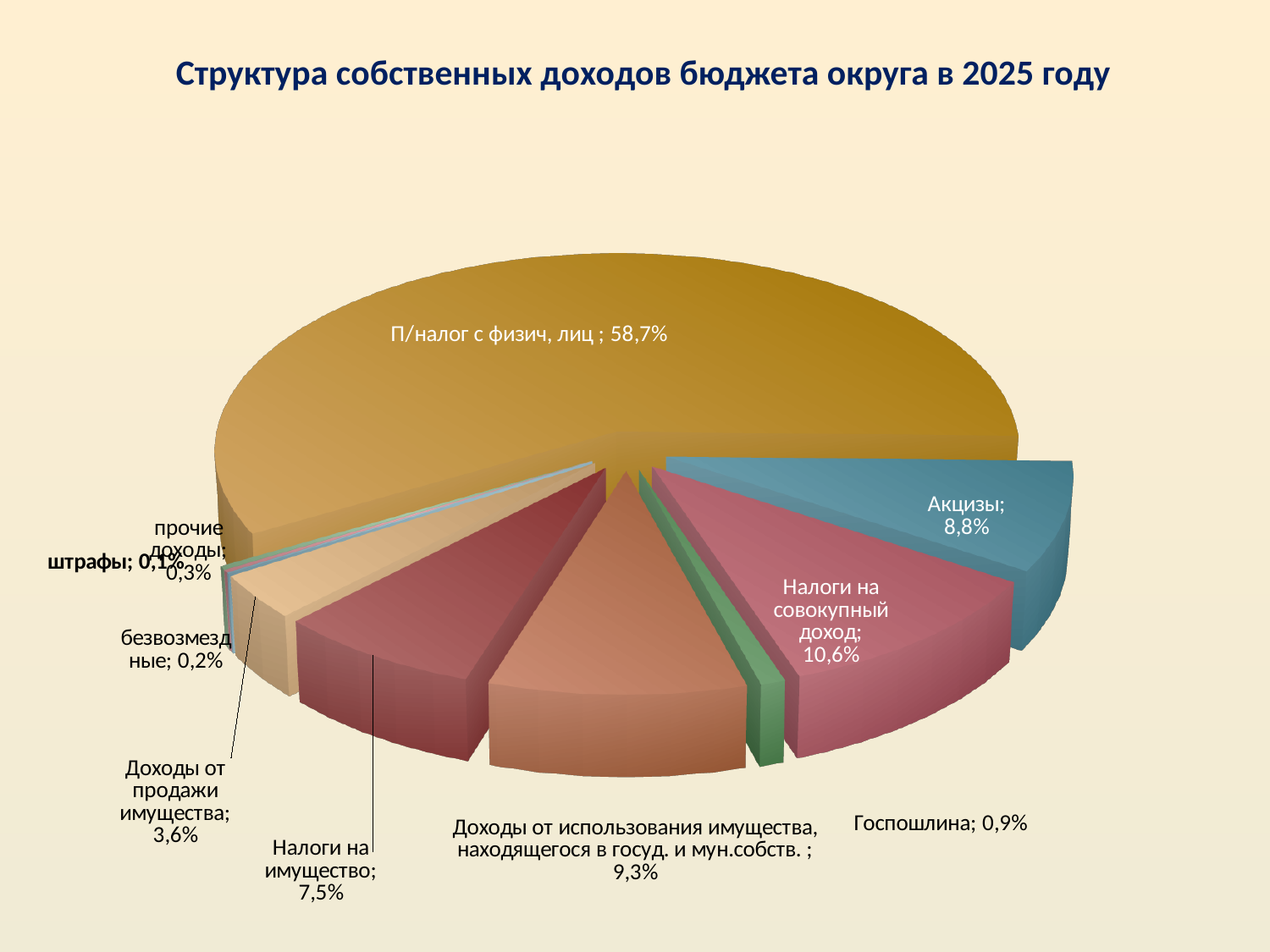
What is the share of "П/налог с физич. лиц" in the pie chart? 58,7% Which category has the largest share of the pie? П/налог с физич. лиц What is the share of "Акцизы"? 8,8% What is the share of "Налоги на имущество"? 7,5% What is the difference between the share of "Доходы от использования имущества, находящегося в госуд. и мун.собств." and the share of "Налоги на имущество"? 1,8% What type of chart is shown on the slide? Pie chart Which category has the smallest share of the pie? штрафы What is the share of "Госпошлина"? 0,9% What is the share of "Налоги на совокупный доход"? 10,6% Which is larger: the share of "Налоги на совокупный доход" or the share of "Акцизы"? Налоги на совокупный доход What is the title of the chart? Структура собственных доходов бюджета округа в 2025 году How many categories (slices) does the pie chart have? 10